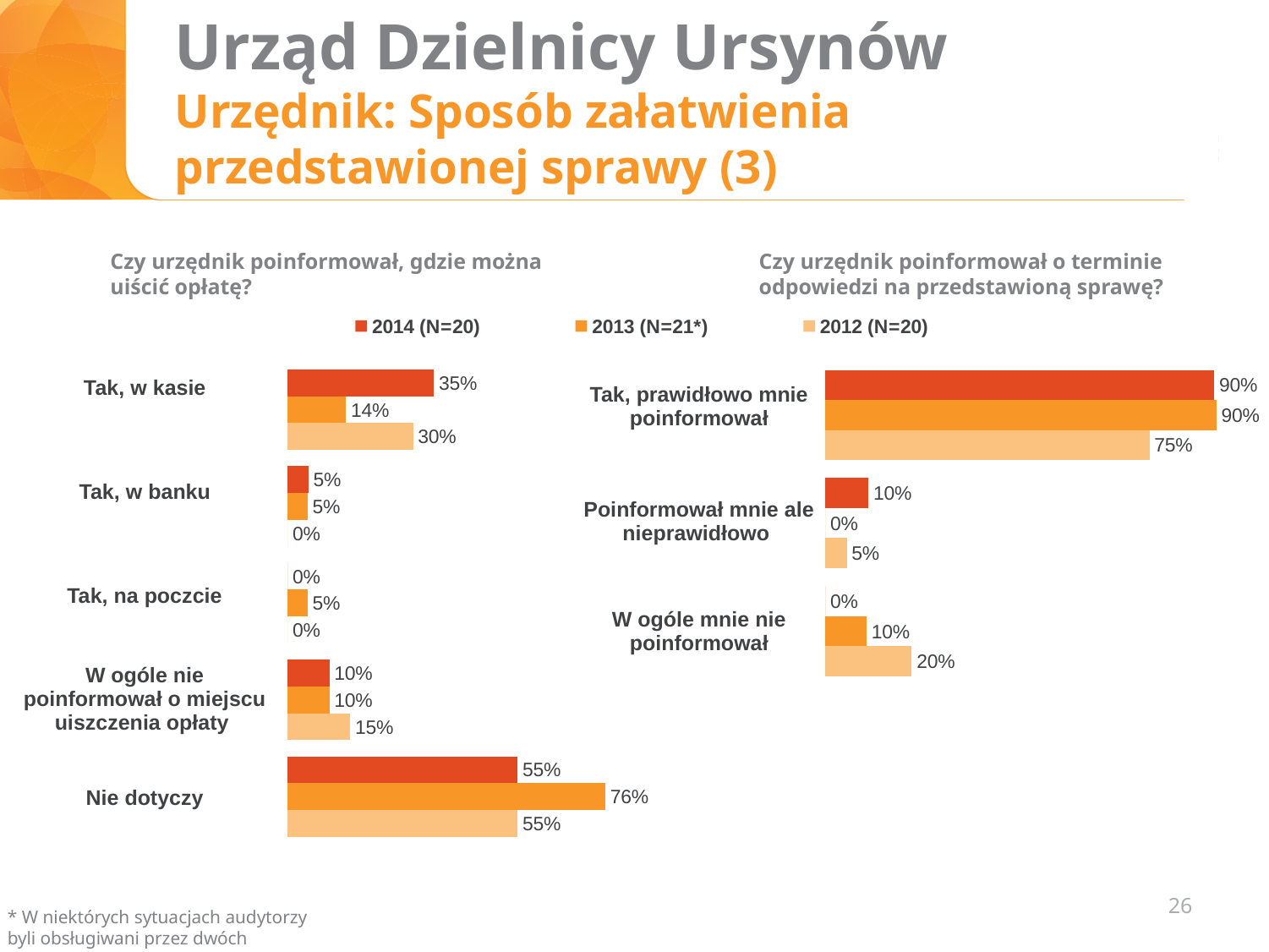
In the right chart ("Czy urzędnik poinformował o terminie odpowiedzi na przedstawioną sprawę?"), which is larger for "Poinformował mnie ale nieprawidłowo": the 2014 value or the 2012 value? 2014 What type of chart is the left chart ("Czy urzędnik poinformował, gdzie można uiścić opłatę?")? Bar chart In the left chart ("Czy urzędnik poinformował, gdzie można uiścić opłatę?"), which category has the highest value in the 2012 (N=20) series? Nie dotyczy In the right chart ("Czy urzędnik poinformował o terminie odpowiedzi na przedstawioną sprawę?"), what is the value for "W ogóle mnie nie poinformował" in the 2013 (N=21*) series? 10% In the left chart ("Czy urzędnik poinformował, gdzie można uiścić opłatę?"), what is the value for "Tak, w kasie" in the 2014 (N=20) series? 35% In the right chart ("Czy urzędnik poinformował o terminie odpowiedzi na przedstawioną sprawę?"), what is the value for "Tak, prawidłowo mnie poinformował" in the 2012 (N=20) series? 75% How many series does the legend list for the charts on this slide? 3 In the left chart ("Czy urzędnik poinformował, gdzie można uiścić opłatę?"), what is the difference between the 2014 and 2013 values for "Tak, w kasie"? 21% In the left chart ("Czy urzędnik poinformował, gdzie można uiścić opłatę?"), what is the value for "Nie dotyczy" in the 2013 (N=21*) series? 76% In the left chart ("Czy urzędnik poinformował, gdzie można uiścić opłatę?"), how many categories are shown? 5 In the right chart ("Czy urzędnik poinformował o terminie odpowiedzi na przedstawioną sprawę?"), what is the difference between the 2012 and 2014 values for "W ogóle mnie nie poinformował"? 20% In the right chart ("Czy urzędnik poinformował o terminie odpowiedzi na przedstawioną sprawę?"), how many categories are shown? 3